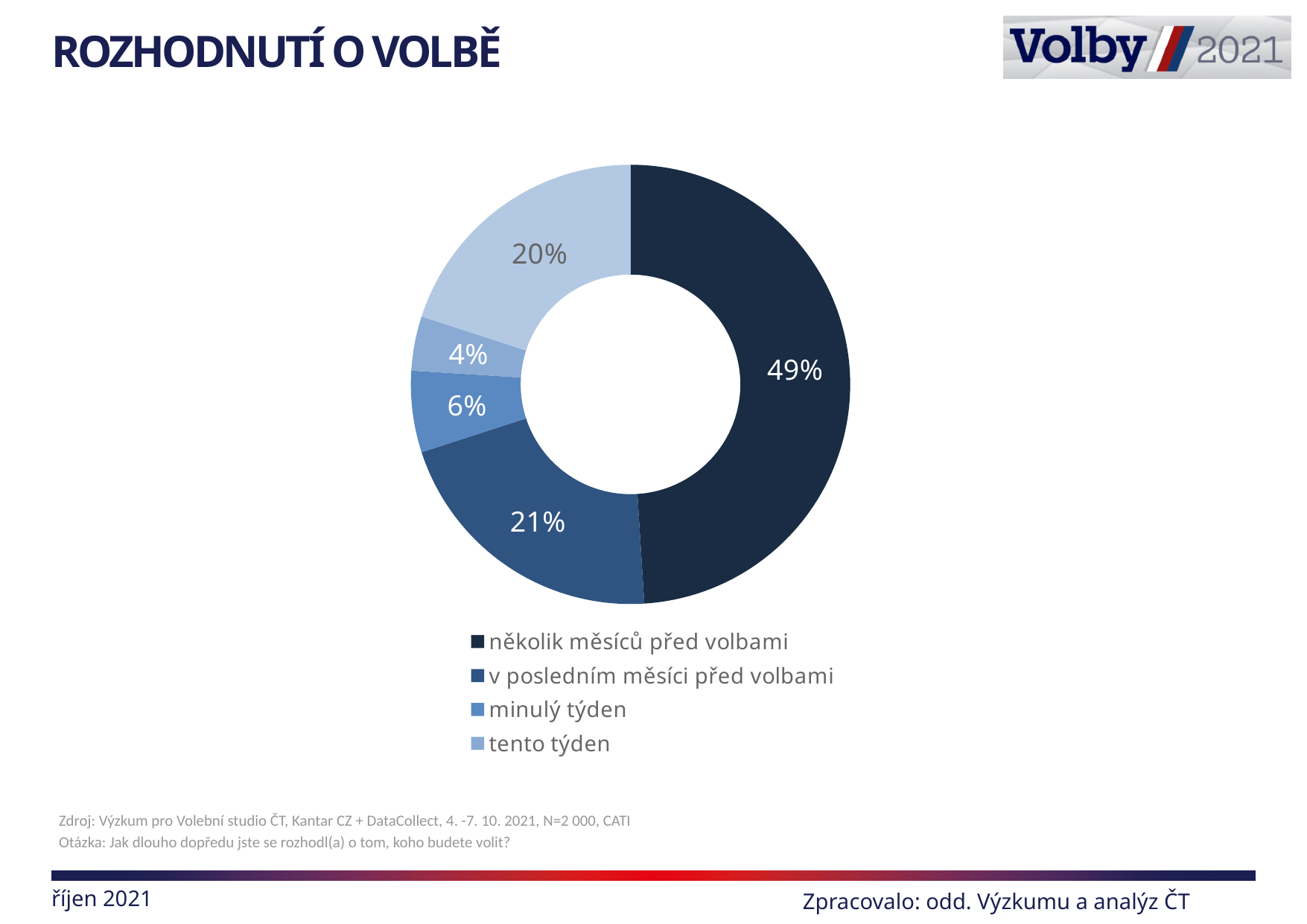
Which is larger: the share for 'v posledním měsíci před volbami' or for 'tento týden'? v posledním měsíci před volbami How many slices does the doughnut chart have? 5 What share of respondents decided 'tento týden'? 4% Which category has the largest share in the chart? několik měsíců před volbami What is the difference in percentage points between 'několik měsíců před volbami' and 'v posledním měsíci před volbami'? 28 How many entries does the legend list? 4 What is the smallest percentage labelled on the chart? 4% What share of respondents decided 'několik měsíců před volbami'? 49% What is the title of the slide? ROZHODNUTÍ O VOLBĚ What kind of chart is shown on the slide? doughnut (pie) chart What share of respondents decided 'v posledním měsíci před volbami'? 21% What share of respondents decided 'minulý týden'? 6%